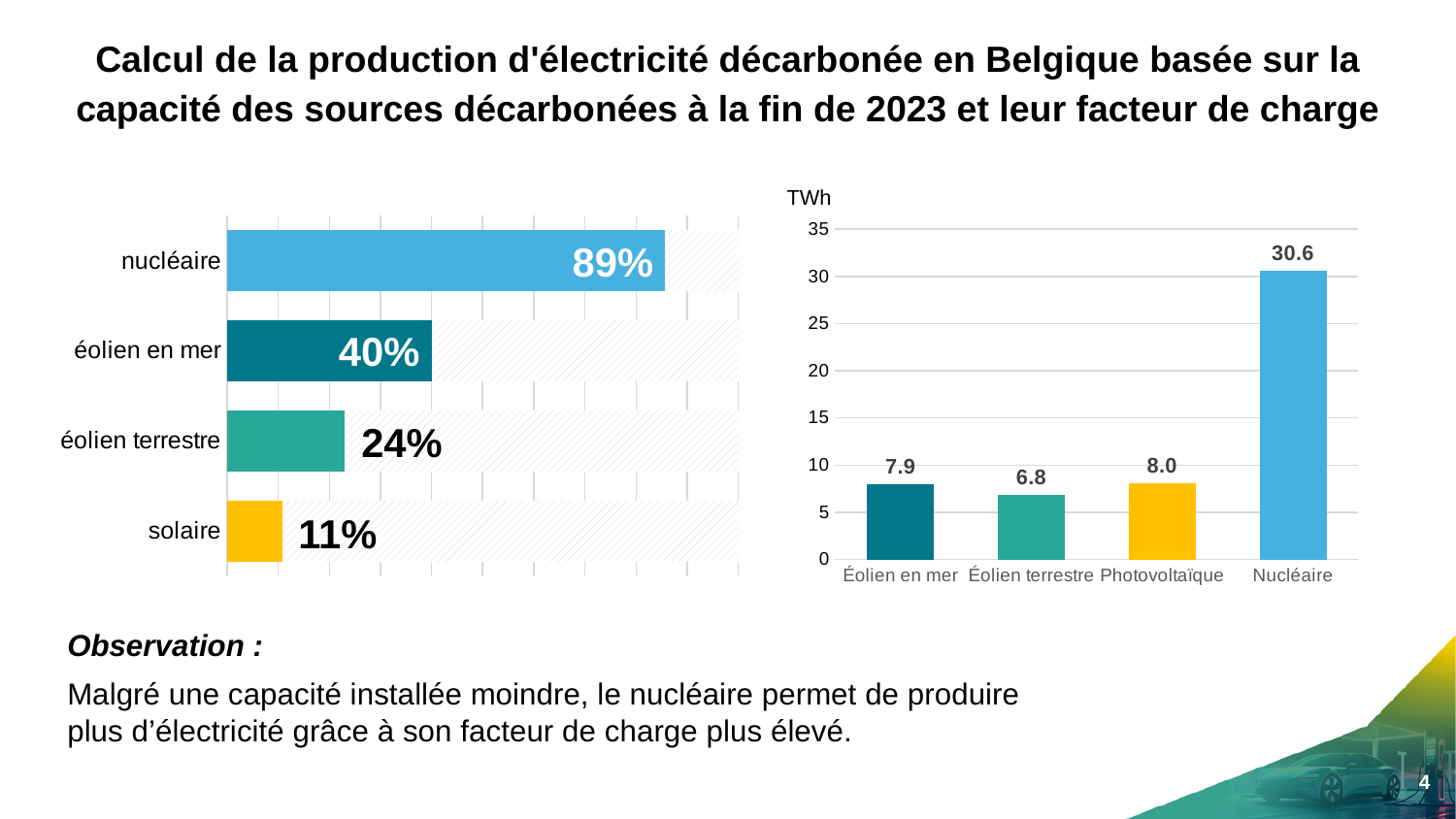
In the right chart, what is the value for Nucléaire? 30.6 In the left chart, how many categories are shown? 4 In the right chart, what is the value for Éolien terrestre? 6.8 In the left chart, what is the difference between the values for éolien en mer and solaire? 29% What kind of chart is the left chart? bar chart In the left chart, what is the value for nucléaire? 89% In the left chart, which category has the lowest value? solaire In the right chart, what is the difference between the values for Nucléaire and Photovoltaïque? 22.6 In the right chart, which is larger, the value for Éolien en mer or the value for Photovoltaïque? Photovoltaïque What unit is shown on the y axis of the right chart? TWh In the left chart, what is the value for éolien terrestre? 24% In the right chart, which category has the highest value? Nucléaire